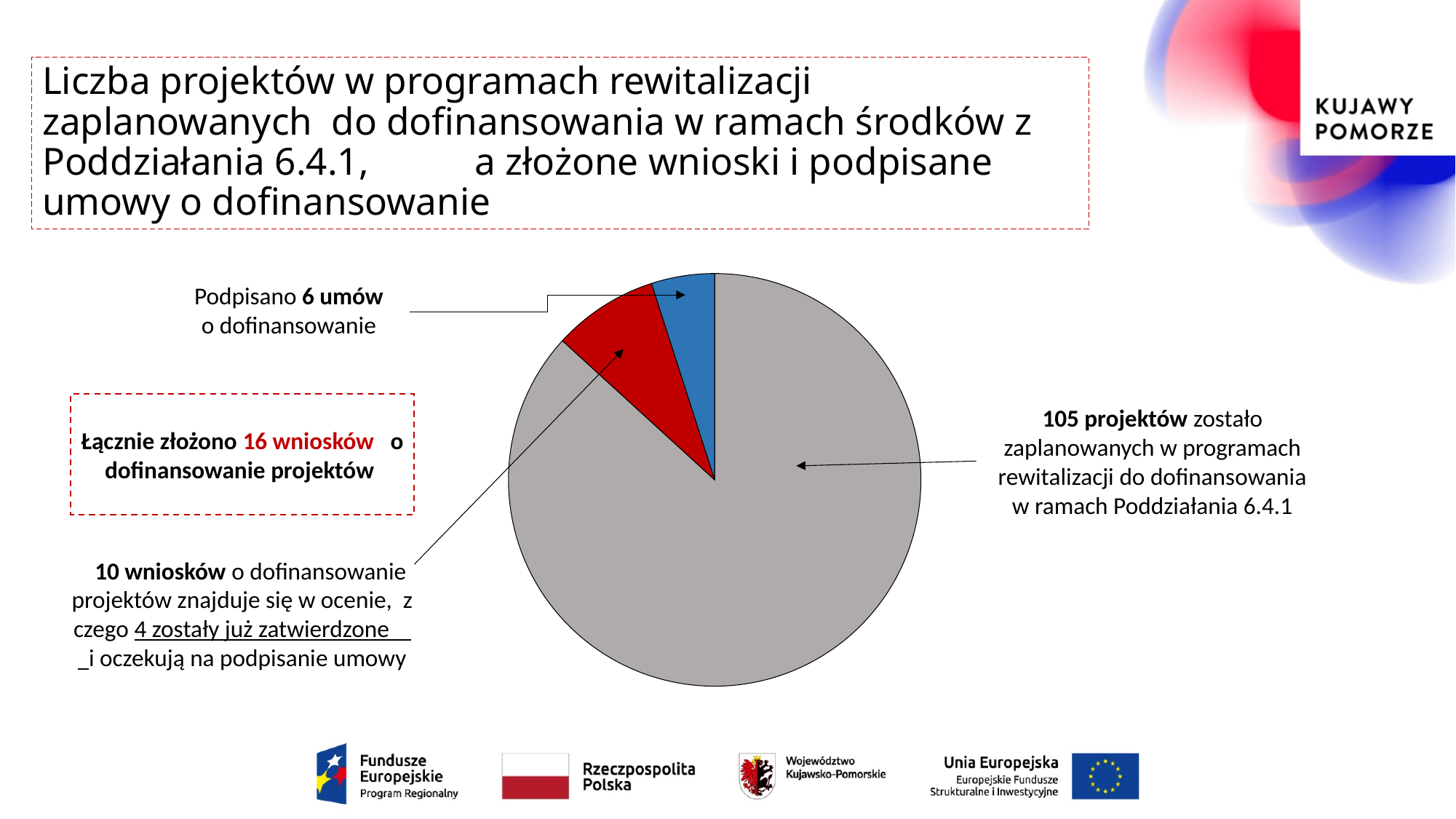
What is the difference between the number of applications under evaluation (10) and the number of signed agreements (6)? 4 Which slice of the pie chart is the smallest? 6 umów (signed agreements, blue slice) Which slice of the pie chart is the largest? 105 projektów (planned projects, grey slice) Which is larger: the number of applications under evaluation or the number of signed agreements? applications under evaluation (10) What is the difference between the number of planned projects (105) and the number of signed agreements (6)? 99 What colour is the slice representing the 6 signed funding agreements? blue How many slices does the pie chart have? 3 How many funding agreements (umów o dofinansowanie) were signed, according to the label for the blue slice? 6 How many funding applications (wniosków) are under evaluation, according to the label for the red slice? 10 How many projects were planned in the revitalisation programmes for funding under Sub-measure 6.4.1, according to the grey slice's label? 105 How many funding applications were submitted in total (Łącznie złożono), according to the slide? 16 What kind of chart is shown on the slide? pie chart